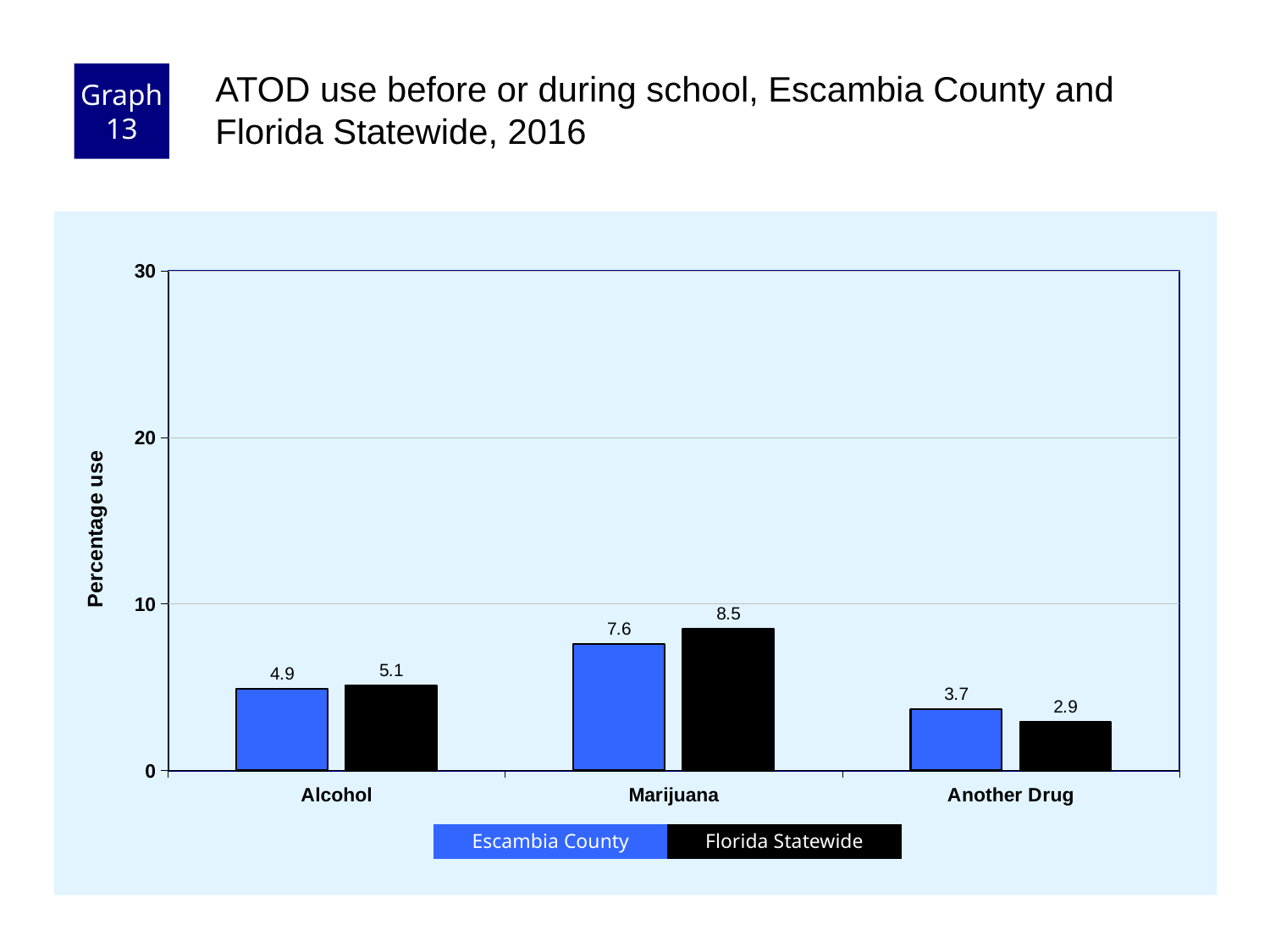
How many categories are shown on the x axis? 3 What kind of chart is shown on the slide? bar chart Which category has the highest Escambia County value? Marijuana What is the difference between the Florida Statewide and Escambia County values for Marijuana? 0.9 What is the Florida Statewide value for Marijuana? 8.5 What is the label of the y axis? Percentage use What is the Florida Statewide value for Another Drug? 2.9 Is the Florida Statewide value for Marijuana greater or less than 10? less For Another Drug, which is larger: Escambia County or Florida Statewide? Escambia County Which category has the lowest Florida Statewide value? Another Drug What is the Escambia County value for Alcohol? 4.9 How many series does the legend list? 2